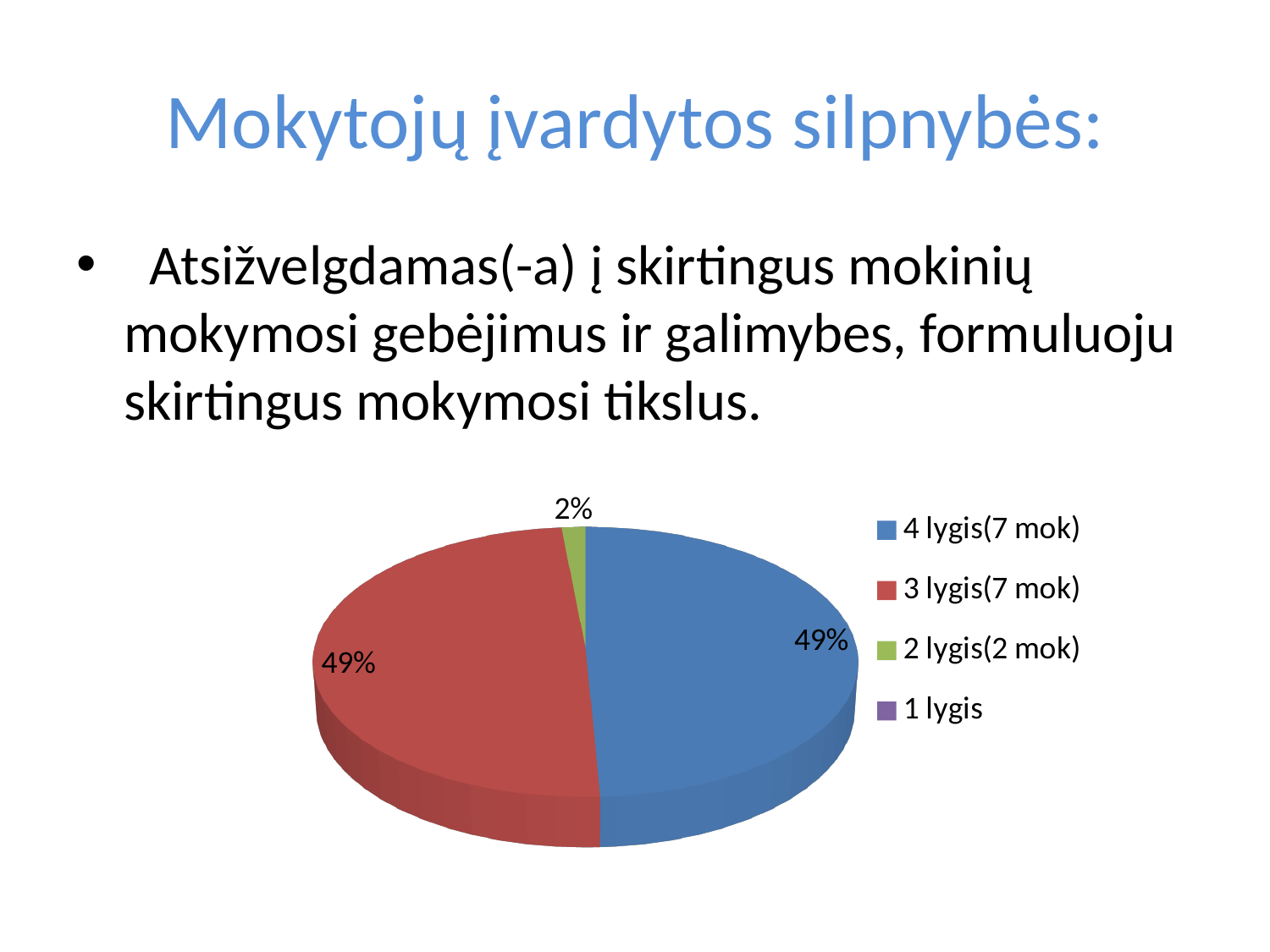
Which of the labelled slices of the pie is the smallest? 2 lygis(2 mok) What percentage of the pie does the 4 lygis(7 mok) slice represent? 49% How many entries does the legend of the pie chart list? 4 Is the share for 2 lygis(2 mok) greater or less than 10%? less What kind of chart is shown on the slide? pie chart What percentage of the pie does the 3 lygis(7 mok) slice represent? 49% What percentage of the pie does the 2 lygis(2 mok) slice represent? 2% What is the difference between the share for 3 lygis(7 mok) and the share for 2 lygis(2 mok)? 47% Which is larger, the share for 4 lygis(7 mok) or the share for 2 lygis(2 mok)? 4 lygis(7 mok) What colour is the 3 lygis(7 mok) slice in the pie chart? red Which legend entry is shown in green? 2 lygis(2 mok)